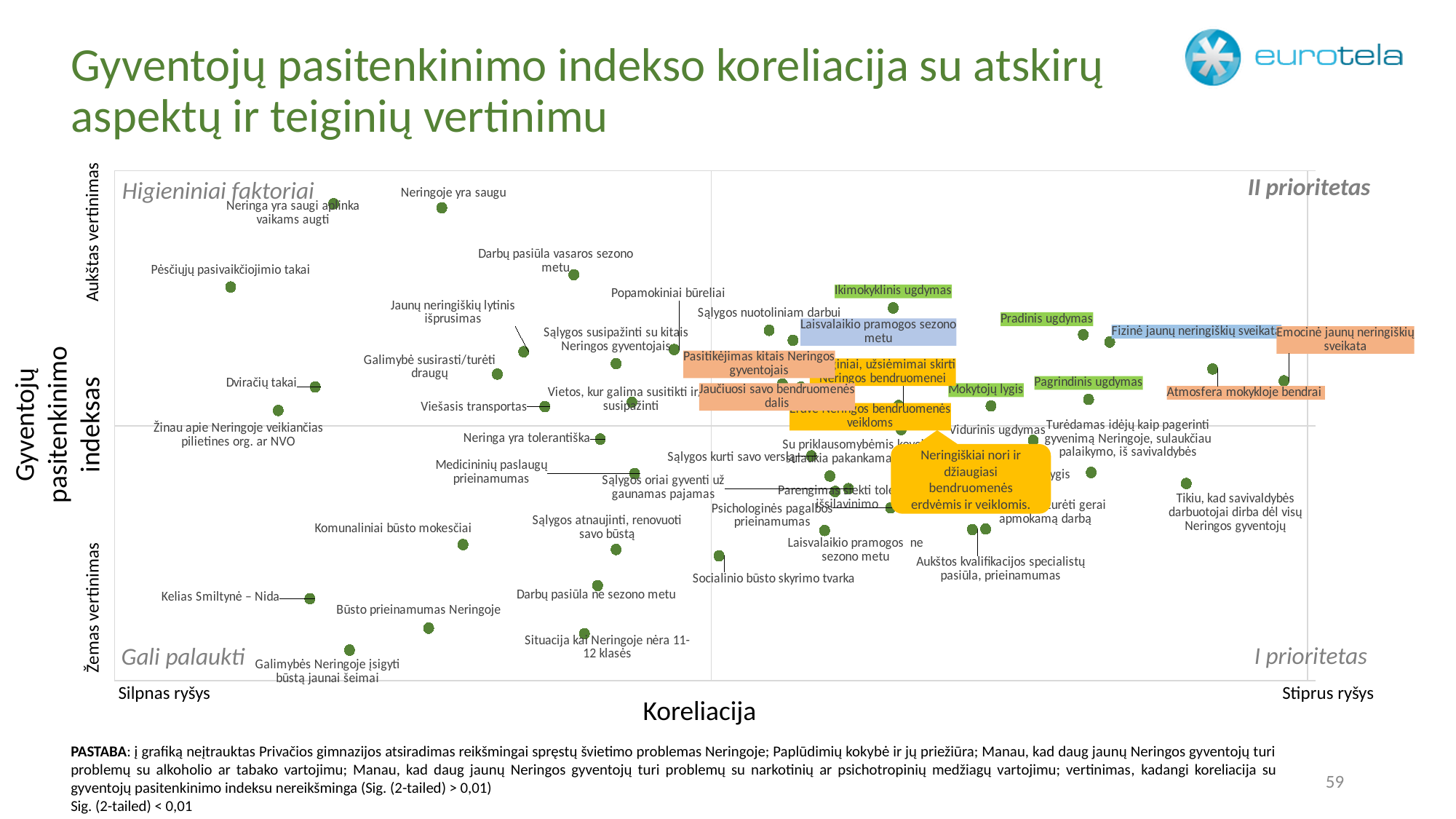
Which point is plotted further to the right: 'Neringoje yra saugu' or 'Pradinis ugdymas'? Pradinis ugdymas What kind of chart is shown on the slide? scatter plot In which quadrant of the chart does the point 'Socialinio būsto skyrimo tvarka' lie? I prioritetas Which point is plotted lowest on the vertical axis? Galimybės Neringoje įsigyti būstą jaunai šeimai Which point is plotted lower on the vertical axis: 'Darbų pasiūla ne sezono metu' or 'Darbų pasiūla vasaros sezono metu'? Darbų pasiūla ne sezono metu In which quadrant of the chart does the point 'Komunaliniai būsto mokesčiai' lie? Gali palaukti In which quadrant of the chart does the point 'Ikimokyklinis ugdymas' lie? II prioritetas Which point is plotted higher on the vertical axis: 'Kelias Smiltynė – Nida' or 'Dviračių takai'? Dviračių takai What is the label of the horizontal axis of the chart? Koreliacija Which point is plotted furthest to the right on the horizontal axis? Emocinė jaunų neringiškių sveikata Which point is plotted furthest to the left on the horizontal axis? Pėsčiųjų pasivaikščiojimio takai What is the label of the vertical axis of the chart? Gyventojų pasitenkinimo indeksas